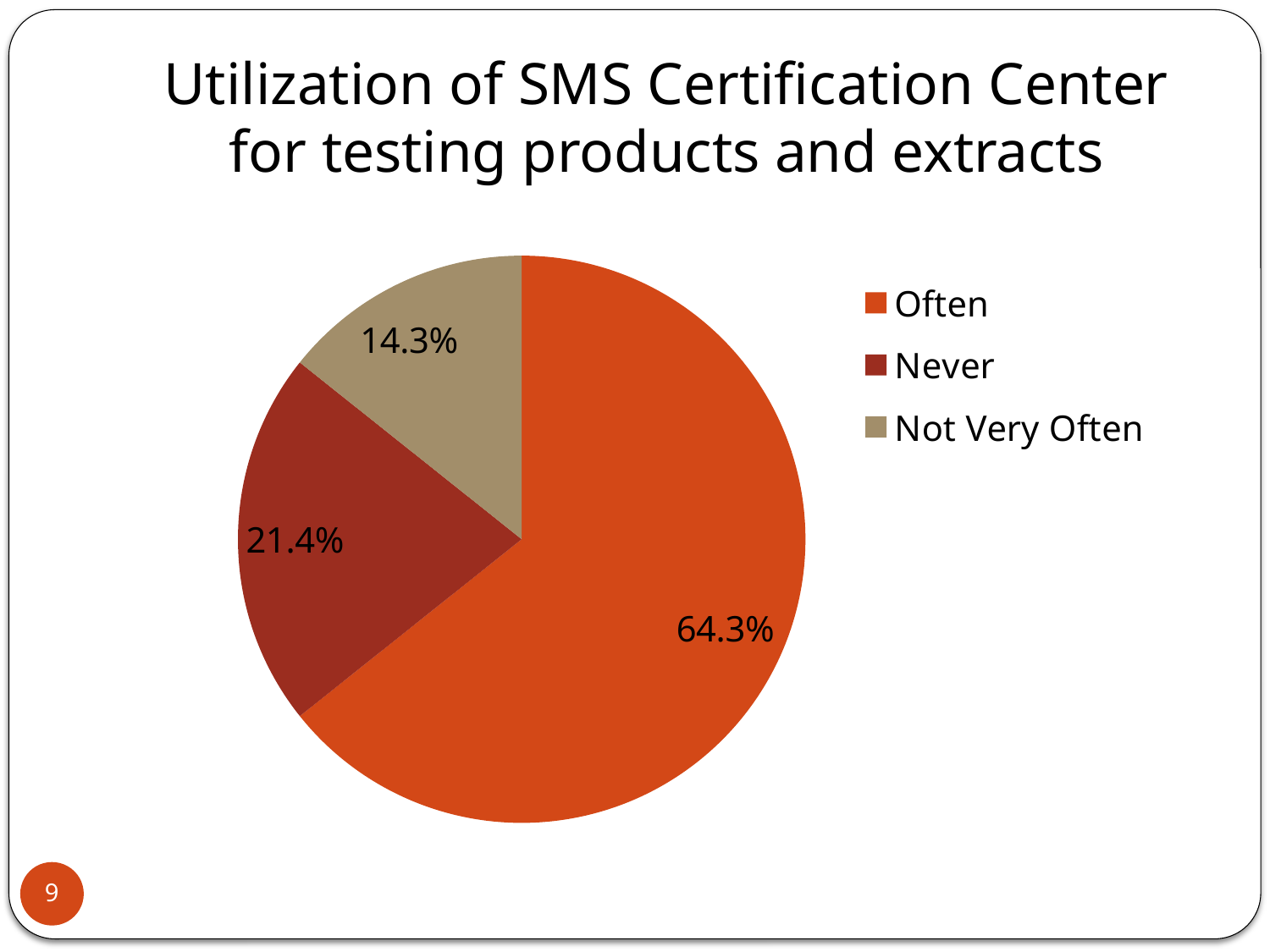
What share of the pie does the Not Very Often slice represent? 14.3% What share of the pie does the Often slice represent? 64.3% What is the difference in percentage points between the Never slice and the Not Very Often slice? 7.1 What share of the pie does the Never slice represent? 21.4% Which category has the smallest slice of the pie? Not Very Often What is the title of the chart on the slide? Utilization of SMS Certification Center for testing products and extracts Which category has the largest slice of the pie? Often What kind of chart is shown on the slide? pie chart Which slice is larger, Never or Not Very Often? Never How many slices does the pie chart have? 3 What is the difference in percentage points between the Often slice and the Never slice? 42.9 How many entries does the legend list? 3